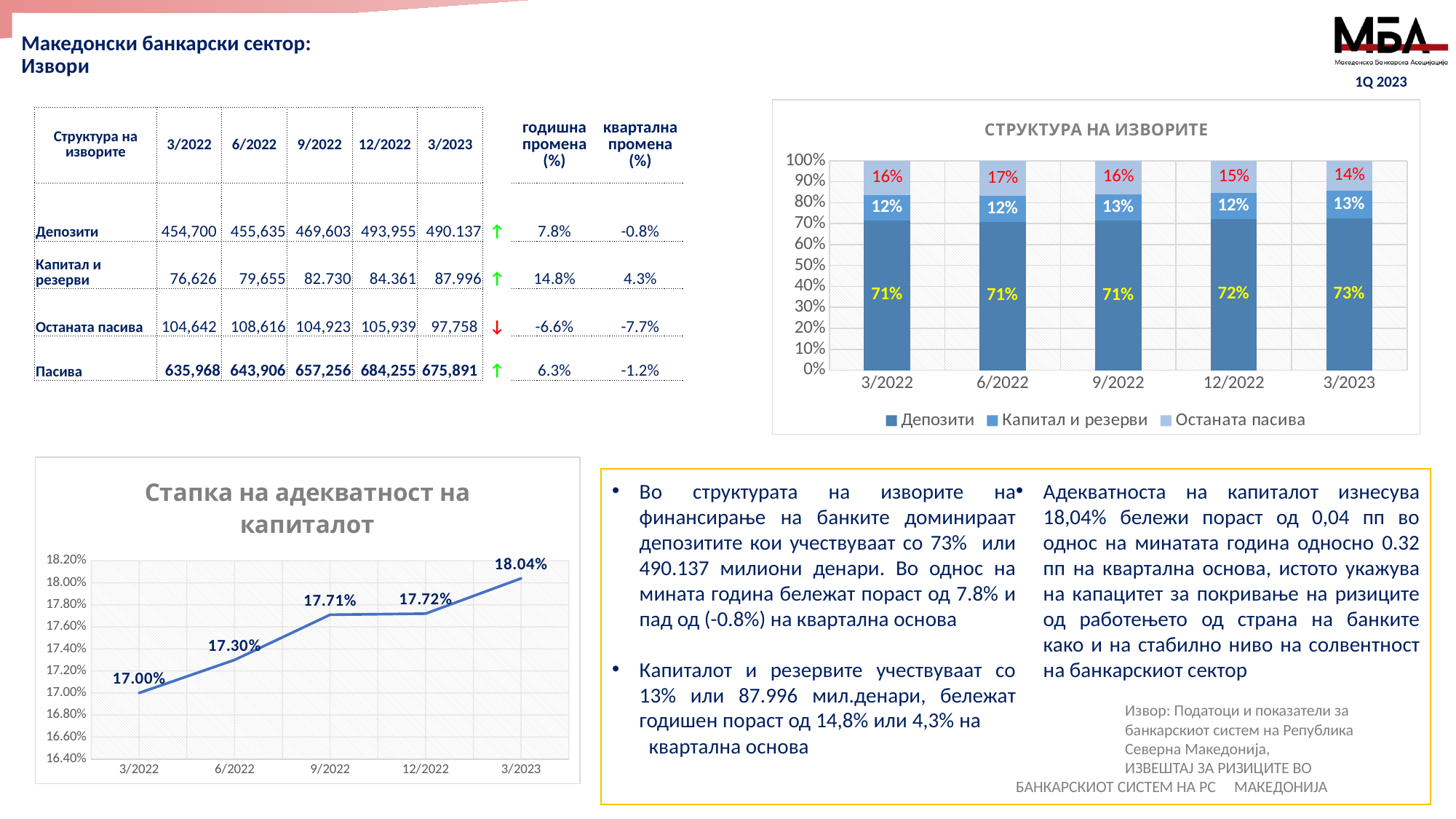
In the 'Стапка на адекватност на капиталот' chart, which period has the lowest value? 3/2022 In the 'СТРУКТУРА НА ИЗВОРИТЕ' chart, what is the share of Капитал и резерви in 9/2022? 13% In the 'Стапка на адекватност на капиталот' chart, do the values rise or fall from 3/2022 to 3/2023? Rise In the 'Стапка на адекватност на капиталот' chart, what is the value for 6/2022? 17.30% In the 'СТРУКТУРА НА ИЗВОРИТЕ' chart, what is the share of Останата пасива in 6/2022? 17% In the 'Стапка на адекватност на капиталот' chart, what is the difference between the values for 3/2023 and 3/2022? 1.04 percentage points In the 'СТРУКТУРА НА ИЗВОРИТЕ' chart, what is the difference between the Депозити share and the Останата пасива share in 12/2022? 57 percentage points In the 'СТРУКТУРА НА ИЗВОРИТЕ' chart, in which period is the share of Останата пасива lowest? 3/2023 In the 'СТРУКТУРА НА ИЗВОРИТЕ' chart, how many series does the legend list? 3 In the 'СТРУКТУРА НА ИЗВОРИТЕ' chart, what is the share of Депозити in 3/2023? 73% In the 'Стапка на адекватност на капиталот' chart, what is the value for 3/2023? 18.04% In the 'СТРУКТУРА НА ИЗВОРИТЕ' chart, what type of chart is shown? Stacked bar chart